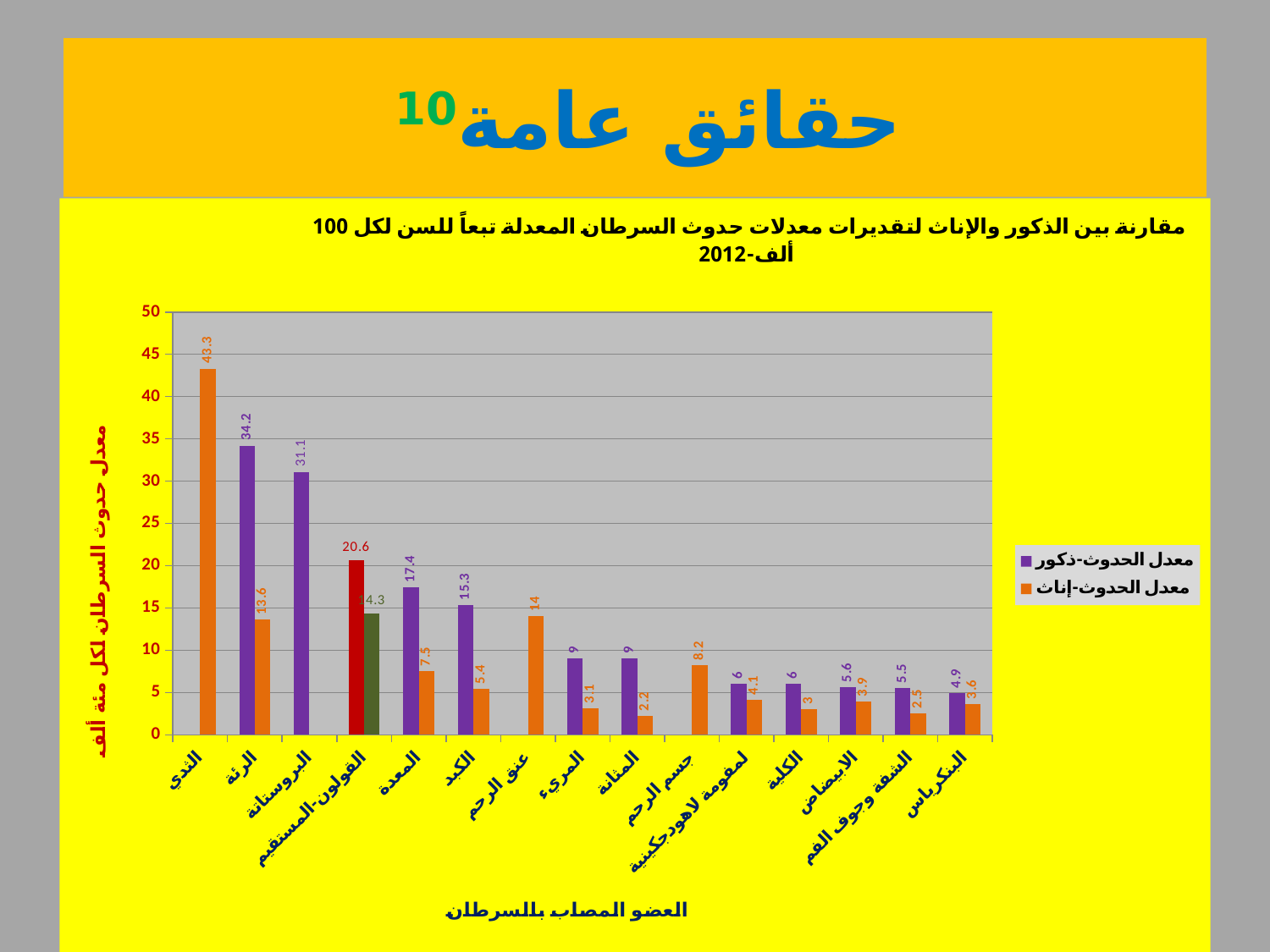
What is the difference between the male and female incidence rates for الرئة (lung)? 20.6 What is the male incidence rate for البروستاتة (prostate)? 31.1 Which category has the highest value on the chart? الثدي Which is larger: the male rate for المعدة (stomach) or the male rate for الكبد (liver)? المعدة (stomach) What is the female incidence rate (معدل الحدوث-إناث) for الثدي (breast)? 43.3 What is the male incidence rate (معدل الحدوث-ذكور) for الرئة (lung)? 34.2 Which colour represents معدل الحدوث-إناث (female incidence rate) in the legend? orange What type of chart is shown on the slide? bar chart What is the female incidence rate for عنق الرحم (cervix)? 14 How many cancer site categories are shown on the x axis? 15 What is the difference between the male and female rates for القولون-المستقيم (colon-rectum)? 6.3 How many series does the legend list? 2